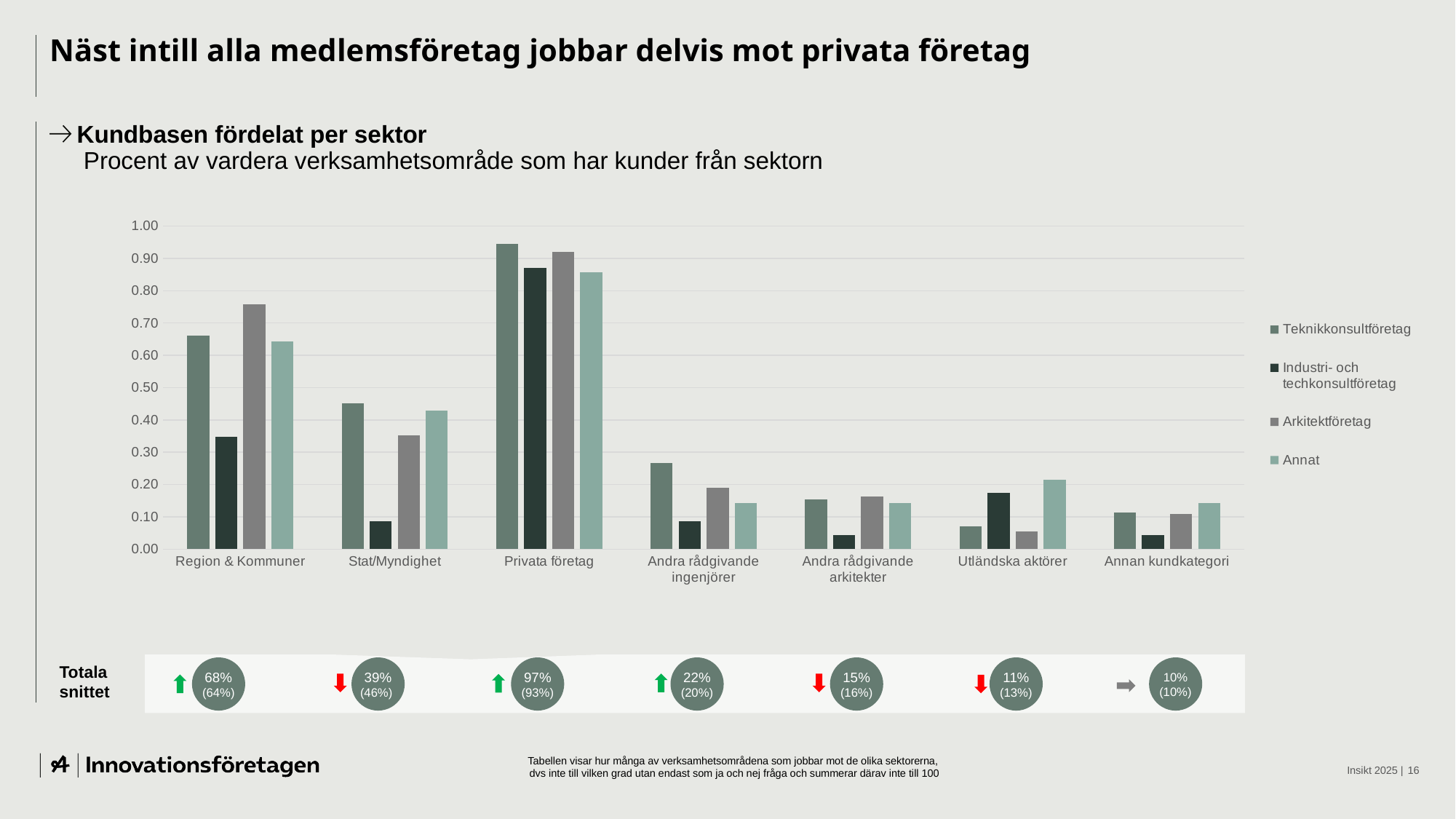
For Region & Kommuner, which is larger: the Arkitektföretag bar or the Teknikkonsultföretag bar? Arkitektföretag What kind of chart is shown on the slide? bar chart Is the Teknikkonsultföretag value for Privata företag greater or less than 0.90? greater Is the Industri- och techkonsultföretag value for Stat/Myndighet greater or less than 0.10? less Is the Teknikkonsultföretag value for Andra rådgivande ingenjörer greater or less than 0.20? greater How many customer categories are shown on the x axis of the chart? 7 Which category has the highest value for Teknikkonsultföretag? Privata företag How many series does the chart legend list? 4 Which category has the lowest value for Arkitektföretag? Utländska aktörer Which series is shown in the darkest colour in the legend? Industri- och techkonsultföretag What is the 'Totala snittet' value shown below the chart for Privata företag? 97%